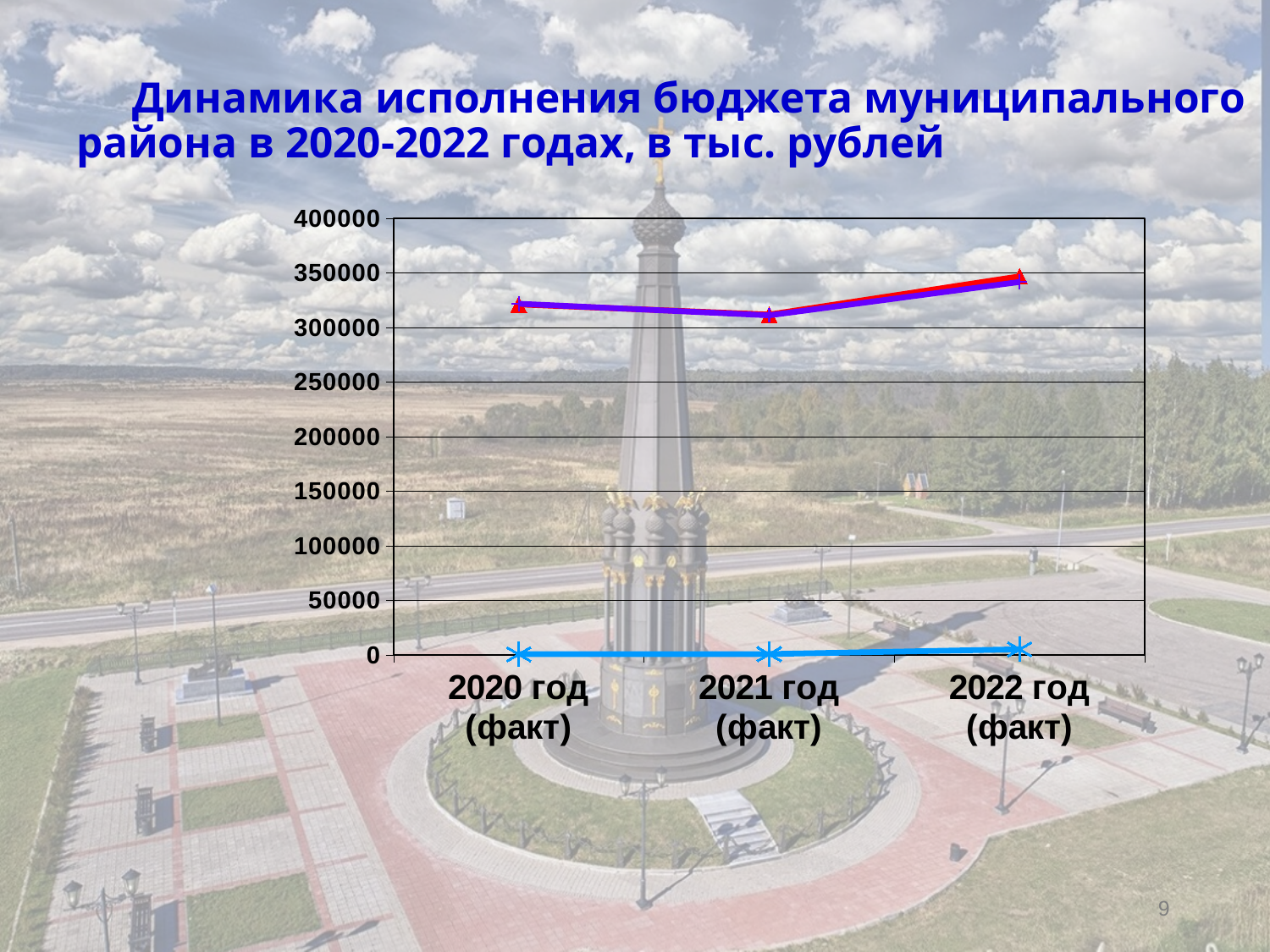
For the red triangle-marked line, which year has the lowest value? 2021 год (факт) How does the red triangle-marked line change from 2021 год (факт) to 2022 год (факт)? rises Is the value of the red triangle-marked line for 2022 год (факт) greater or less than 300000? greater What is the highest value shown on the y axis of the chart? 400000 What kind of chart is shown on the slide? line chart What is the title of the chart on the slide? Динамика исполнения бюджета муниципального района в 2020-2022 годах, в тыс. рублей Is the value of the light blue asterisk-marked line for 2021 год (факт) greater or less than 50000? less For the red triangle-marked line, which is larger: the value for 2020 год (факт) or for 2022 год (факт)? 2022 год (факт) Is the value of the red triangle-marked line for 2021 год (факт) greater or less than 350000? less How many categories are shown on the x axis of the chart? 3 For the red triangle-marked line, which year has the highest value? 2022 год (факт)